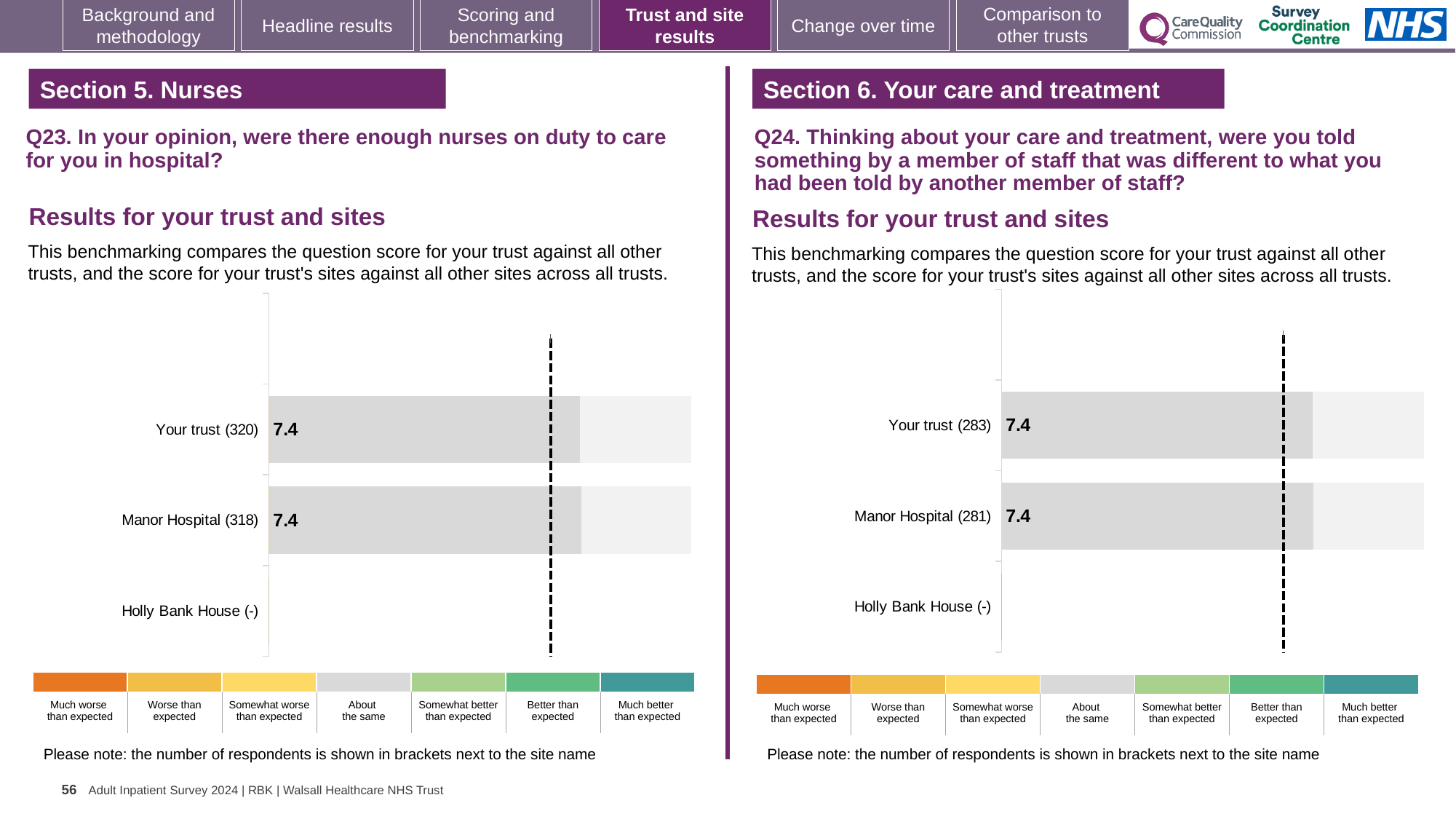
On the Q23 chart (left), what is the score for Your trust? 7.4 What kind of chart is used on the Q23 chart (left)? Bar chart On the Q24 chart (right), how many respondents are shown in brackets for Manor Hospital? 281 How many benchmark categories does the colour key below the Q24 chart (right) list? 7 On the Q23 chart (left), which category has no score shown? Holly Bank House On the Q23 chart (left), what is the difference between the scores for Your trust and Manor Hospital? 0 On the Q23 chart (left), how many respondents are shown in brackets for Your trust? 320 On the Q23 chart (left), what is the score for Manor Hospital? 7.4 On the Q24 chart (right), what is the score for Your trust? 7.4 On the Q24 chart (right), how many sites or categories are listed on the vertical axis? 3 On the Q24 chart (right), what is the score for Manor Hospital? 7.4 On the Q24 chart (right), how many respondents are shown in brackets for Your trust? 283